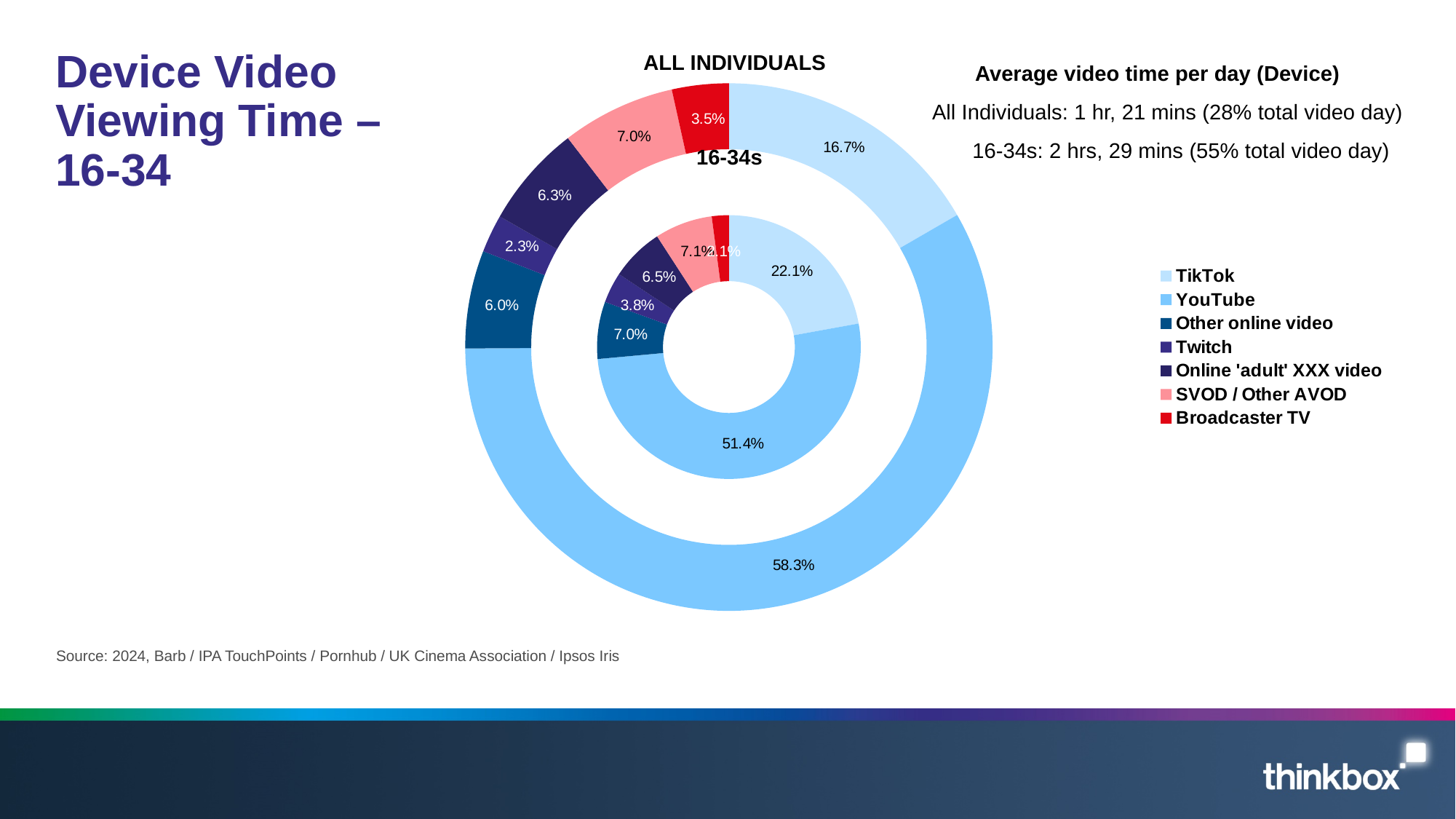
What share of device video viewing time does TikTok account for among 16-34s (inner ring)? 22.1% Which category has the smallest share in the all individuals (outer) ring? Twitch How many percentage points higher is the YouTube share for all individuals (58.3%) than for 16-34s (51.4%)? 6.9 percentage points What is the SVOD / Other AVOD share for 16-34s in the inner ring? 7.1% How many categories does the legend list? 7 Which audience group does the outer ring of the chart represent? All individuals What share of device video viewing time does YouTube account for among all individuals (outer ring)? 58.3% What kind of chart is shown on the slide? Doughnut chart Is the TikTok share larger for all individuals or for 16-34s? 16-34s Which category has the largest share in the all individuals (outer) ring? YouTube What is the Twitch share for all individuals in the outer ring? 2.3% What is the Broadcaster TV share for all individuals in the outer ring? 3.5%